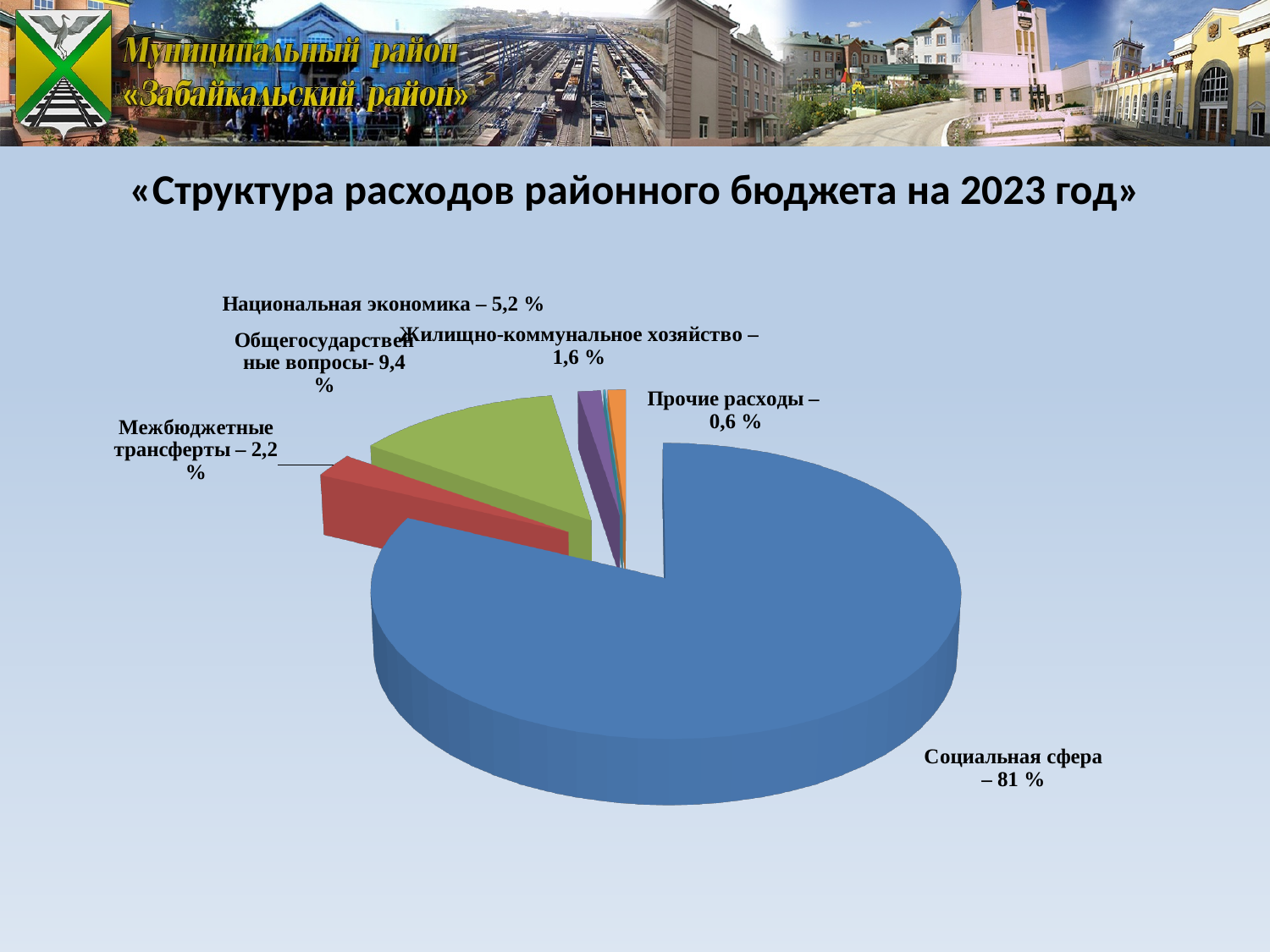
What is the value for Социальная сфера? 81 % What is the value for Национальная экономика? 5,2 % Which category has the largest share of the pie? Социальная сфера What is the value for Межбюджетные трансферты? 2,2 % What is the value for Жилищно-коммунальное хозяйство? 1,6 % What is the difference between the values for Социальная сфера and Общегосударственные вопросы? 71,6 % What kind of chart is shown on the slide? Pie chart What is the value for Общегосударственные вопросы? 9,4 % Which is larger, Национальная экономика or Межбюджетные трансферты? Национальная экономика How many slices does the pie chart have? 6 What is the value for Прочие расходы? 0,6 % Which category has the smallest share of the pie? Прочие расходы